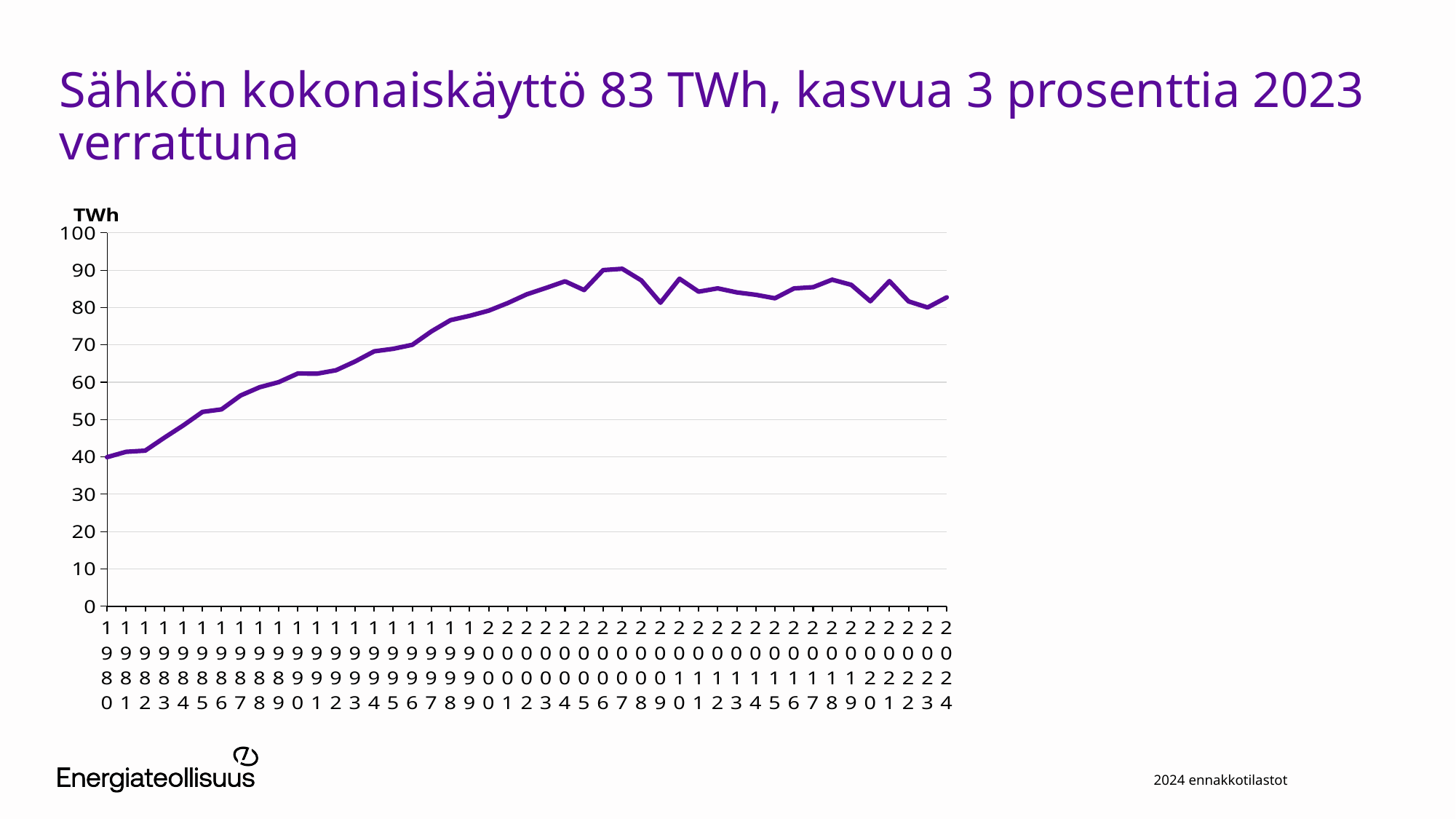
Does electricity consumption generally rise or fall from 1980 to 2007? rise Which year has the higher value, 1990 or 2010? 2010 Which year has the higher value, 1980 or 2024? 2024 How many yearly data points does the line chart plot? 45 Is the value for 1990 greater or less than 60? greater What is the first year shown on the x axis of the chart? 1980 Is the value for 1980 greater or less than 50? less Is the value for 2020 greater or less than 90? less What unit is shown on the y axis of the chart? TWh Which year has the lowest electricity consumption in the chart? 1980 What kind of chart is shown on the slide? line chart